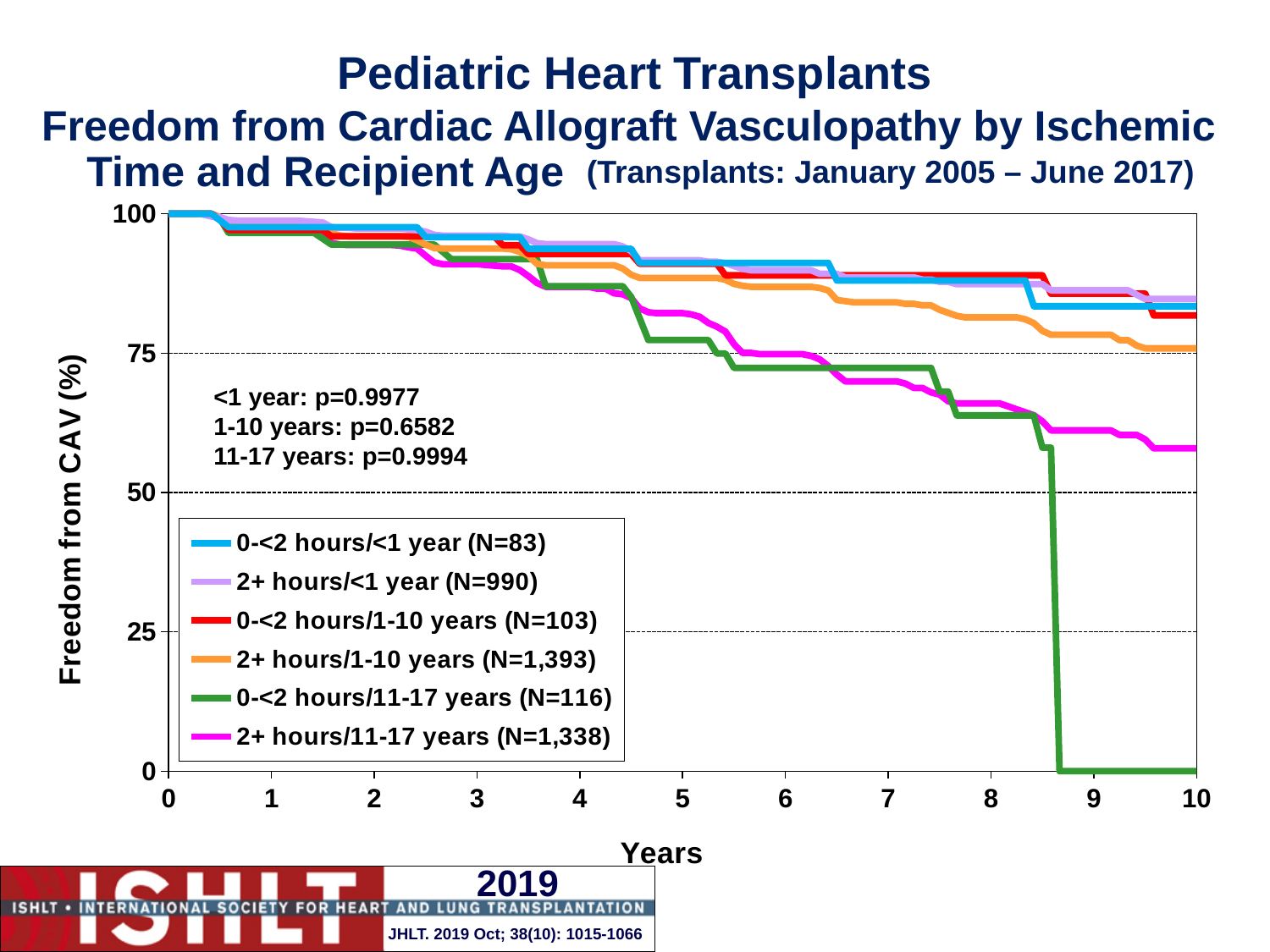
How many series does the legend list? 6 At year 10, which is higher: 2+ hours/1-10 years or 2+ hours/11-17 years? 2+ hours/1-10 years Is the value for 0-<2 hours/<1 year (N=83) at year 10 greater or less than 75? greater What p-value is shown for the 1-10 years comparison? p=0.6582 Is the value for 2+ hours/11-17 years (N=1,338) at year 10 greater or less than 75? less What kind of chart is shown on the slide? line chart What is the N for the 2+ hours/1-10 years series in the legend? 1,393 Is the value for 0-<2 hours/11-17 years (N=116) at year 10 greater or less than 25? less Do the values for the 2+ hours/11-17 years series rise or fall as years increase? fall Which series has the lowest freedom from CAV at year 10? 0-<2 hours/11-17 years (N=116)